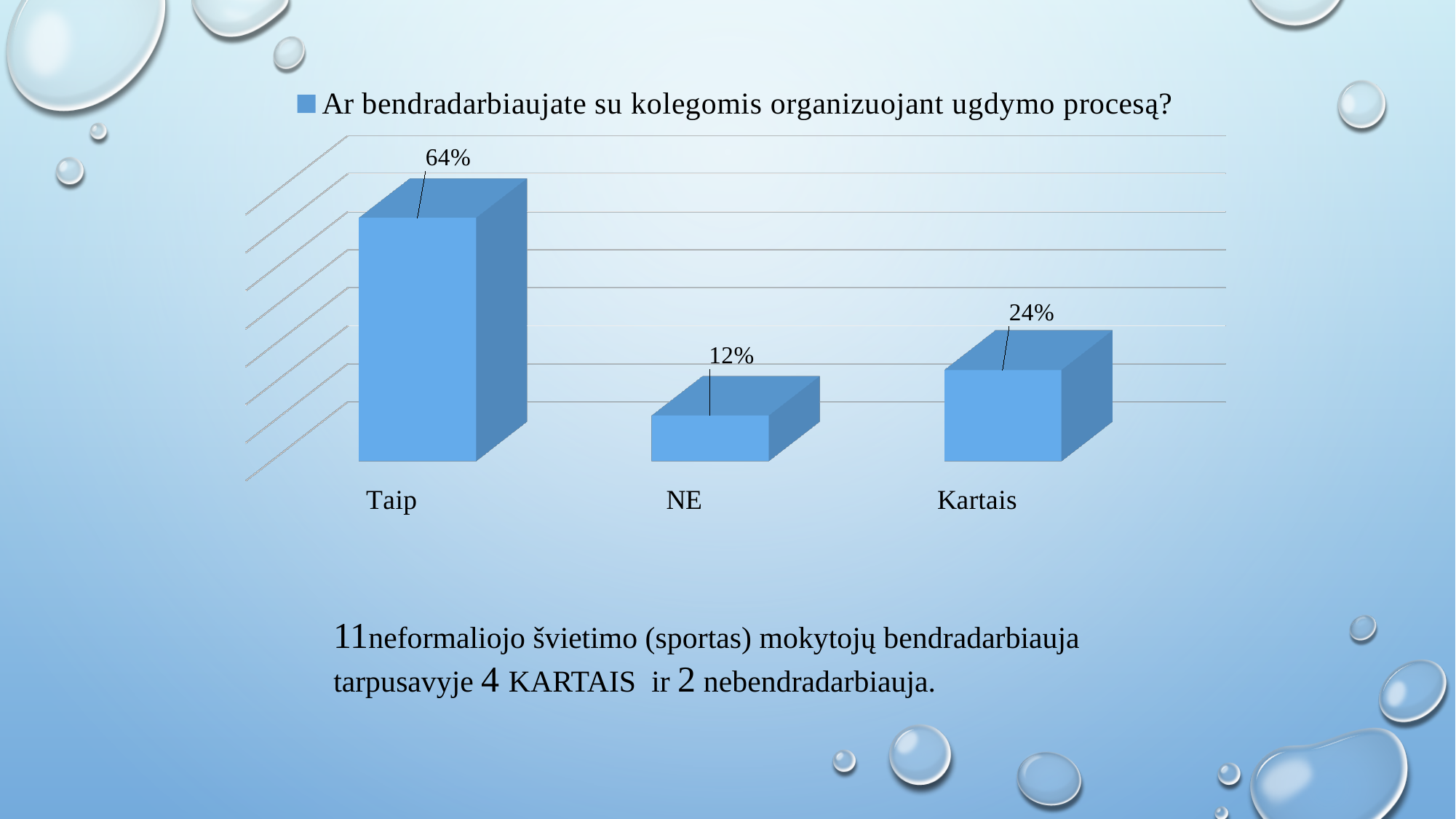
What is the difference between the values for Taip and Kartais? 40% What is the legend entry shown above the chart? Ar bendradarbiaujate su kolegomis organizuojant ugdymo procesą? Which is larger, the value for NE or the value for Kartais? Kartais How many series does the legend list? 1 What is the difference between the values for Kartais and NE? 12% What is the value for Taip? 64% Which category has the lowest value? NE Which category has the highest value? Taip How many categories are shown on the chart? 3 What is the value for Kartais? 24% What kind of chart is shown on the slide? Bar chart What is the value for NE? 12%